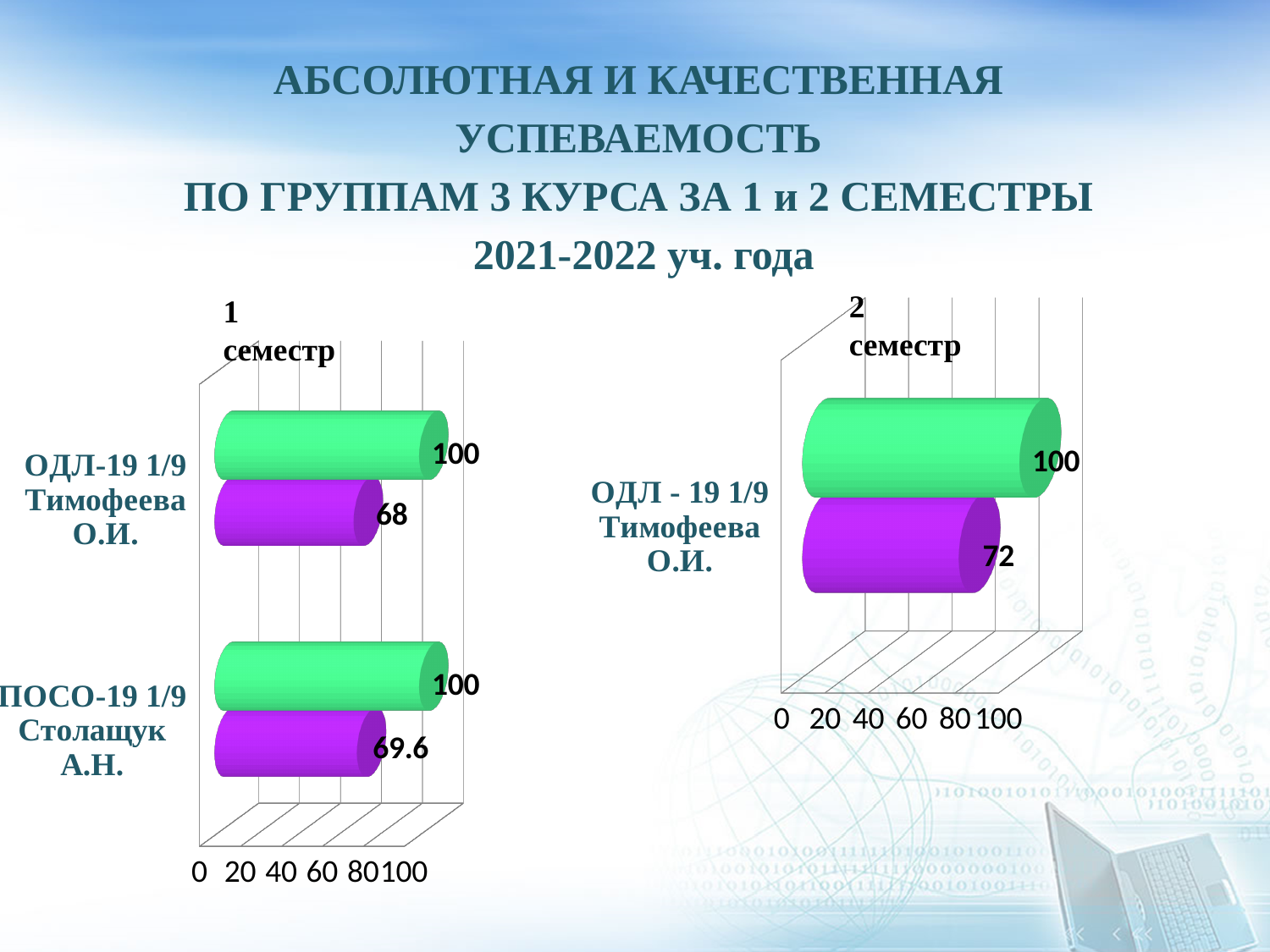
In the "1 семестр" chart, what is the difference between the purple bars for ПОСО-19 1/9 Столащук А.Н. and ОДЛ-19 1/9 Тимофеева О.И.? 1.6 In the "2 семестр" chart, what is the value of the green bar for ОДЛ - 19 1/9 Тимофеева О.И.? 100 In the "1 семестр" chart, what is the value of the purple bar for ОДЛ-19 1/9 Тимофеева О.И.? 68 Which is larger: the purple bar for ОДЛ-19 1/9 Тимофеева О.И. in the "1 семестр" chart or the purple bar for ОДЛ - 19 1/9 Тимофеева О.И. in the "2 семестр" chart? 2 семестр In the "2 семестр" chart, what is the difference between the green and purple bars for ОДЛ - 19 1/9 Тимофеева О.И.? 28 In the "1 семестр" chart, what is the difference between the green and purple bars for ОДЛ-19 1/9 Тимофеева О.И.? 32 In the "1 семестр" chart, is the purple bar for ОДЛ-19 1/9 Тимофеева О.И. greater or less than 80? less In the "1 семестр" chart, what is the value of the purple bar for ПОСО-19 1/9 Столащук А.Н.? 69.6 What type of chart is the "2 семестр" chart? Bar chart How many categories (groups) are shown in the "1 семестр" chart? 2 In the "2 семестр" chart, what is the value of the purple bar for ОДЛ - 19 1/9 Тимофеева О.И.? 72 In the "1 семестр" chart, what is the value of the green bar for ПОСО-19 1/9 Столащук А.Н.? 100